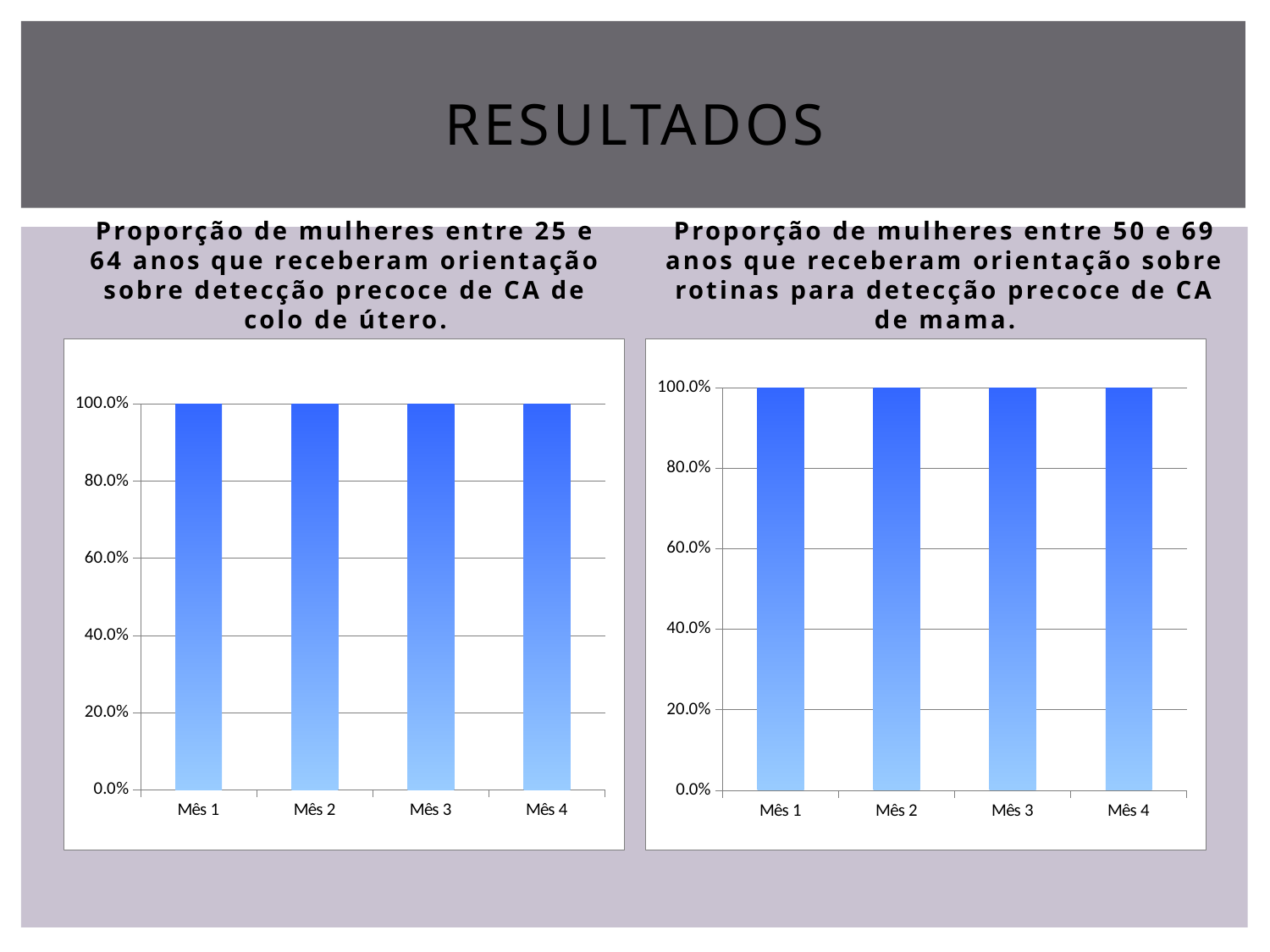
What kind of chart is the left chart (Proporção de mulheres entre 25 e 64 anos)? Bar chart What is the highest value shown on the y axis of the left chart (Proporção de mulheres entre 25 e 64 anos)? 100.0% In the left chart (Proporção de mulheres entre 25 e 64 anos), what is the value for Mês 4? 100.0% In the left chart (Proporção de mulheres entre 25 e 64 anos), do the values rise, fall or stay the same from Mês 1 to Mês 4? Stay the same How many categories are shown on the x axis of the right chart (Proporção de mulheres entre 50 e 69 anos)? 4 What kind of chart is the right chart (Proporção de mulheres entre 50 e 69 anos)? Bar chart In the right chart (Proporção de mulheres entre 50 e 69 anos), what is the value for Mês 3? 100.0% In the left chart (Proporção de mulheres entre 25 e 64 anos), what is the value for Mês 1? 100.0% In the right chart (Proporção de mulheres entre 50 e 69 anos), do the values rise, fall or stay the same from Mês 1 to Mês 4? Stay the same In the right chart (Proporção de mulheres entre 50 e 69 anos), what is the value for Mês 2? 100.0% In the right chart (Proporção de mulheres entre 50 e 69 anos), what is the difference between the values for Mês 1 and Mês 4? 0.0% How many bars are plotted in the left chart (Proporção de mulheres entre 25 e 64 anos)? 4